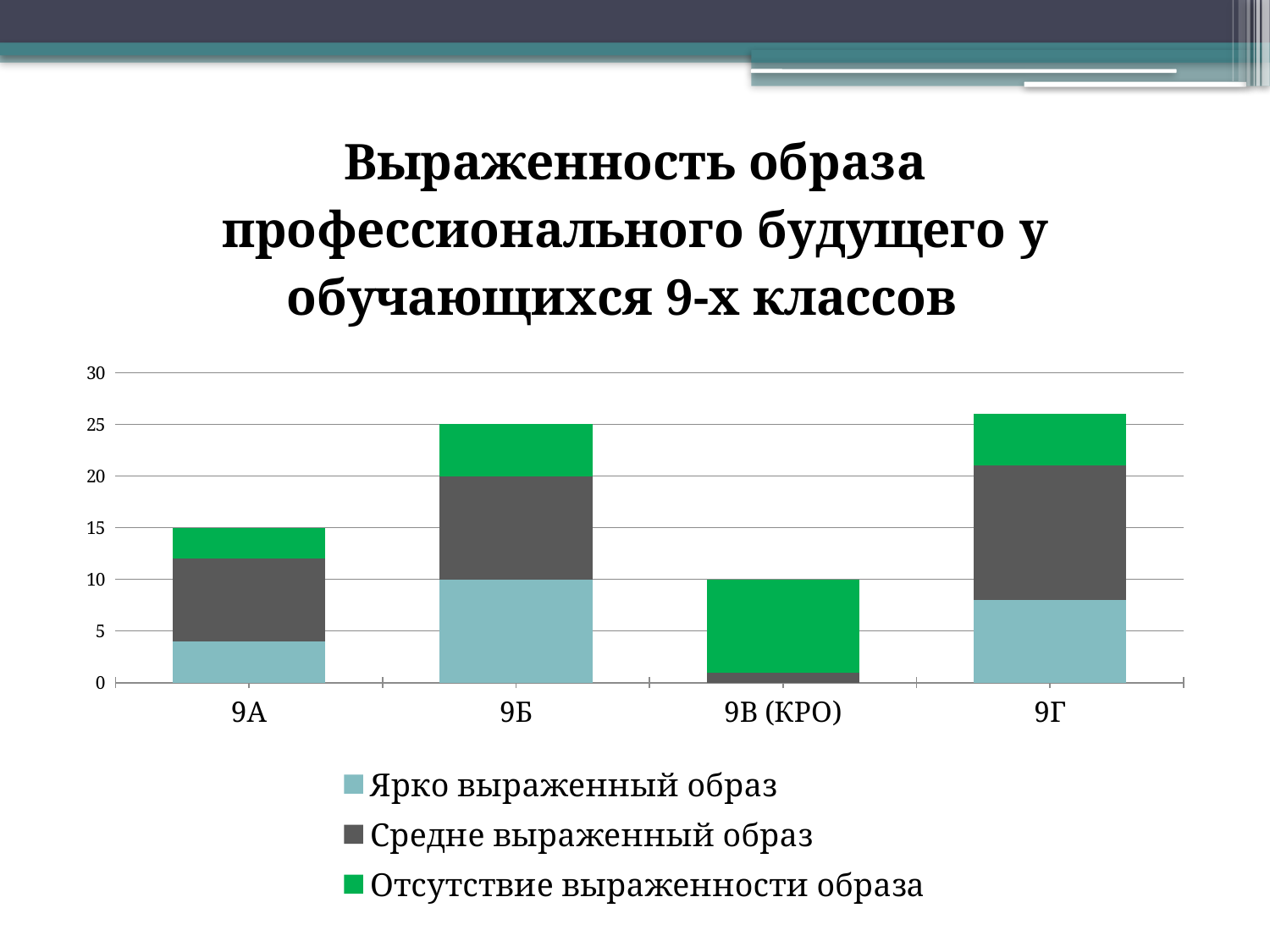
Is the total bar for 9Г greater or less than 25? greater What is the total height of the stacked bar for 9А? 15 Is the value of 'Ярко выраженный образ' for 9А greater or less than 5? less What is the total height of the stacked bar for 9В (КРО)? 10 Which class has the lowest total bar? 9В (КРО) What is the total height of the stacked bar for 9Б? 25 How many classes (categories) are shown on the x axis? 4 How many series does the legend list? 3 What kind of chart is shown on the slide? stacked bar chart What is the value of 'Ярко выраженный образ' for 9Б? 10 Which colour represents 'Отсутствие выраженности образа' in the legend? green Which class has the highest total bar? 9Г